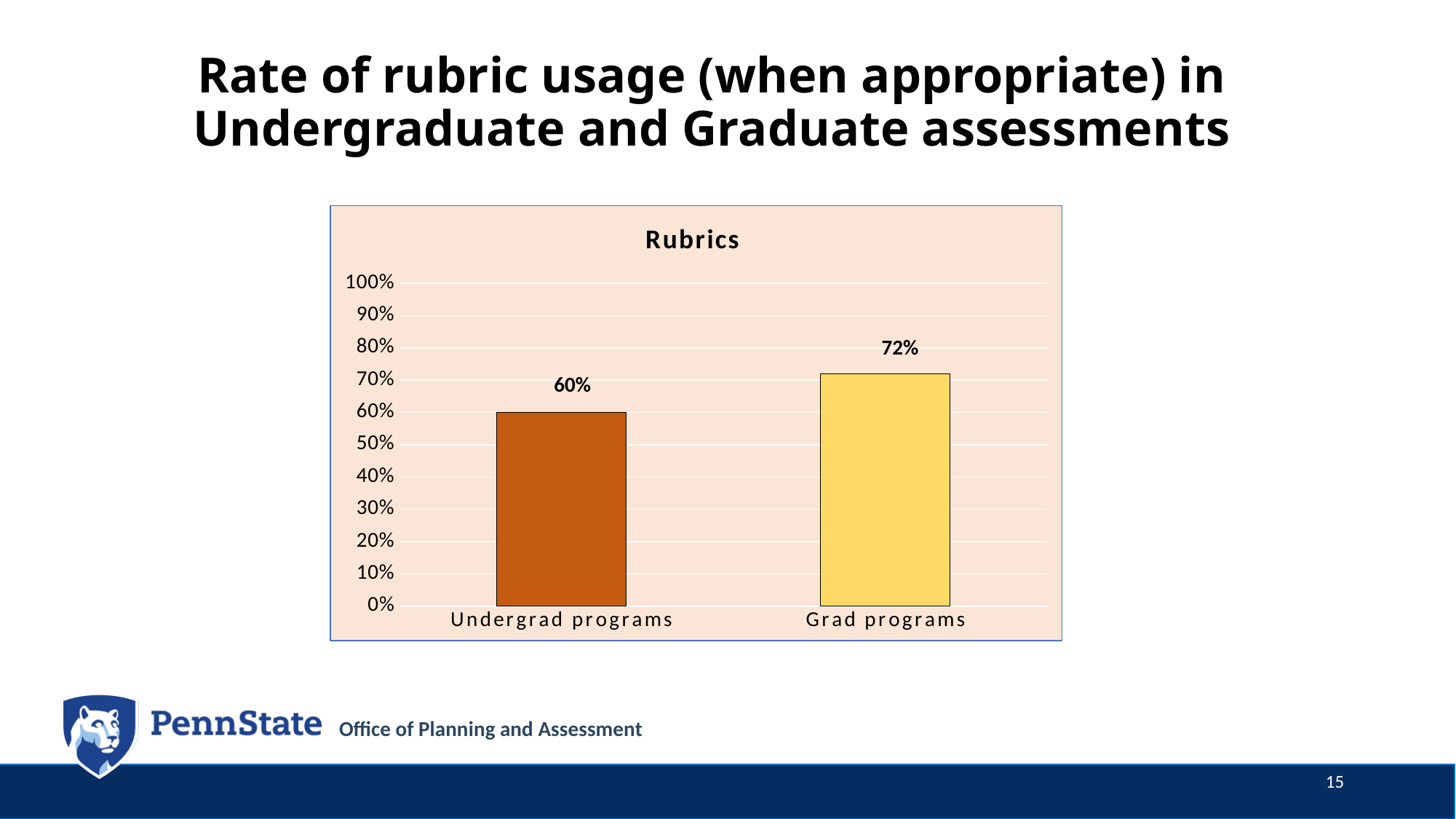
Is the value for Undergrad programs greater or less than 50%? greater What kind of chart is shown on the slide? Bar chart What is the difference in rubric usage between Grad programs and Undergrad programs? 12% What is the rate of rubric usage for Grad programs? 72% How many categories are shown on the chart? 2 What is the rate of rubric usage for Undergrad programs? 60% Which category has the lowest rate of rubric usage? Undergrad programs Is the value for Grad programs greater or less than 80%? less Which category has the highest rate of rubric usage? Grad programs Which is larger, the value for Undergrad programs or the value for Grad programs? Grad programs What is the title of the chart? Rubrics What is the maximum value shown on the vertical axis? 100%